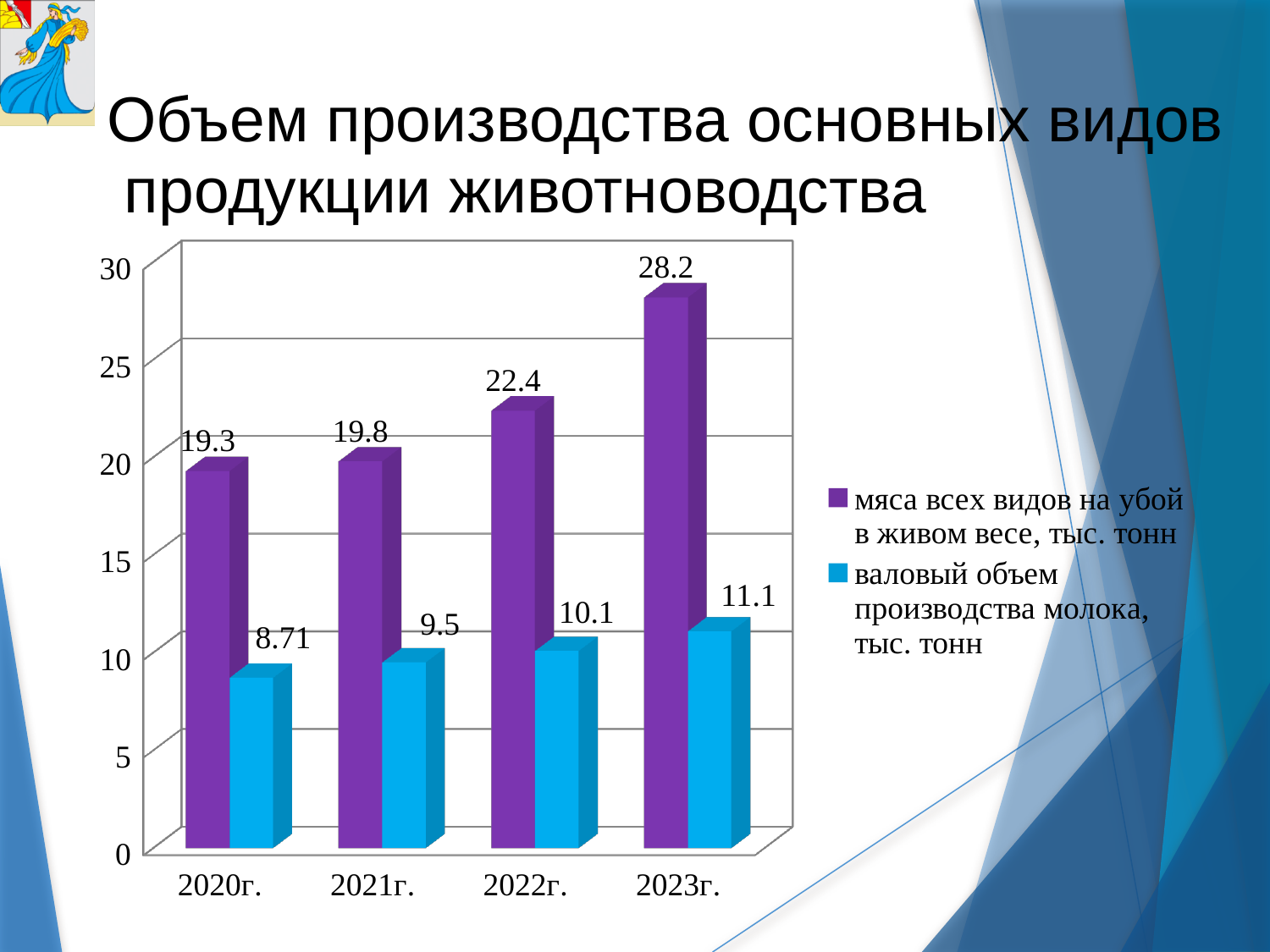
Which is larger: the milk production value in 2022г. or in 2021г.? 2022г. What is the value for meat of all kinds for slaughter in live weight in 2021г.? 19.8 What is the gross volume of milk production (валовый объем производства молока) in 2020г.? 8.71 What is the value for meat of all kinds for slaughter in live weight (мяса всех видов на убой в живом весе) in 2023г.? 28.2 How many years are shown on the x axis? 4 What is the difference between the meat production values for 2023г. and 2022г.? 5.8 Is the value for meat of all kinds for slaughter in live weight in 2022г. greater or less than 20? greater In which year is the value for meat of all kinds for slaughter in live weight lowest? 2020г. How many series does the legend list? 2 In which year is the gross volume of milk production highest? 2023г. What kind of chart is shown on the slide? bar chart Do the values for gross volume of milk production rise or fall from 2020г. to 2023г.? rise